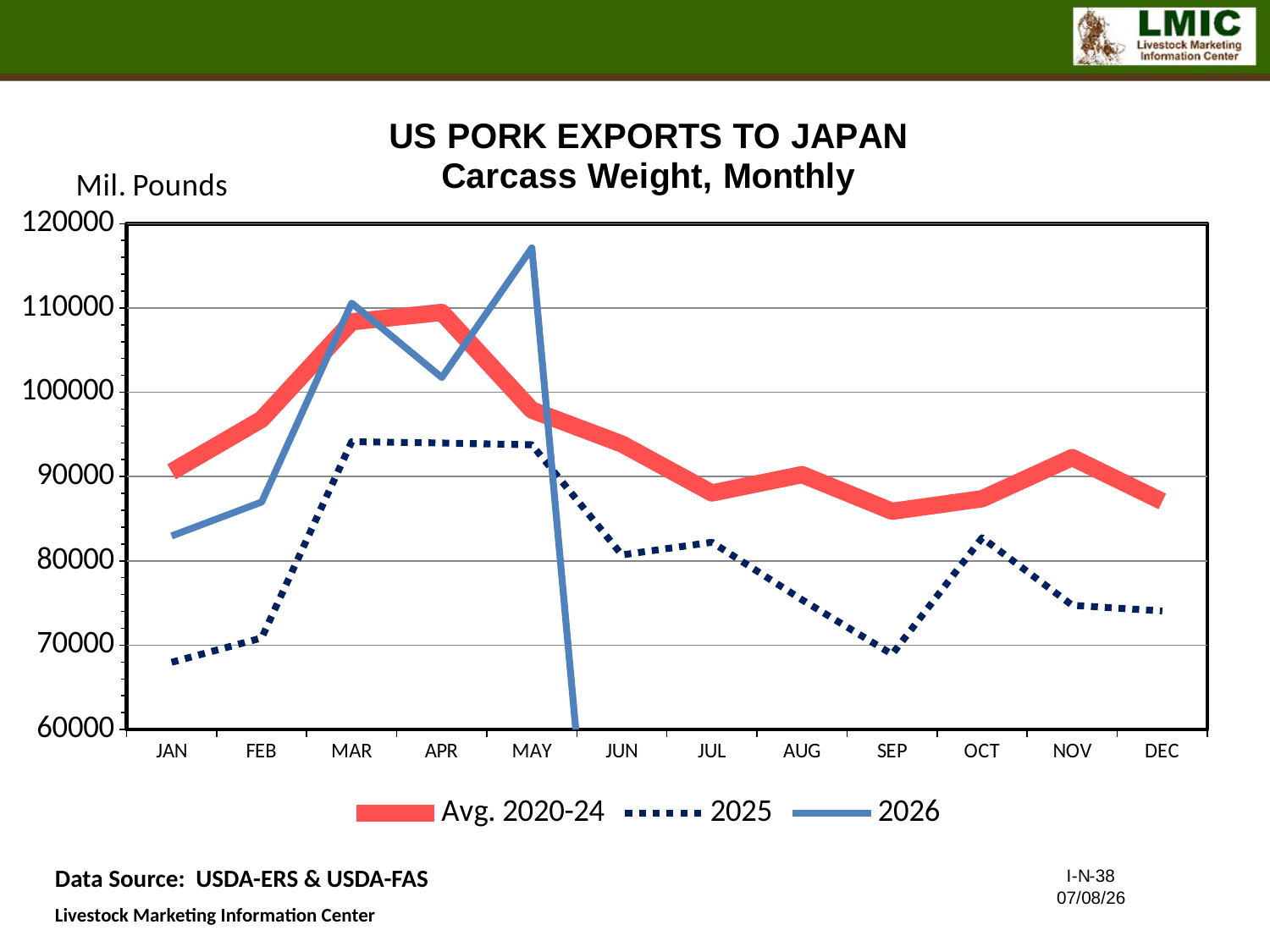
Which is larger in JUN, the Avg. 2020-24 value or the 2025 value? Avg. 2020-24 Is the 2025 value for OCT greater or less than 80000? greater Is the 2026 value for MAY greater or less than 110000? greater How many months are shown along the x axis? 12 In which month does the 2026 series reach its highest value? MAY What unit is shown on the y axis label? Mil. Pounds Is the Avg. 2020-24 value for DEC greater or less than 90000? less How many series does the legend list? 3 Which is larger in MAY, the 2026 value or the 2025 value? 2026 What kind of chart is shown on the slide? Line chart Does the 2025 series rise or fall from MAY to SEP? Fall